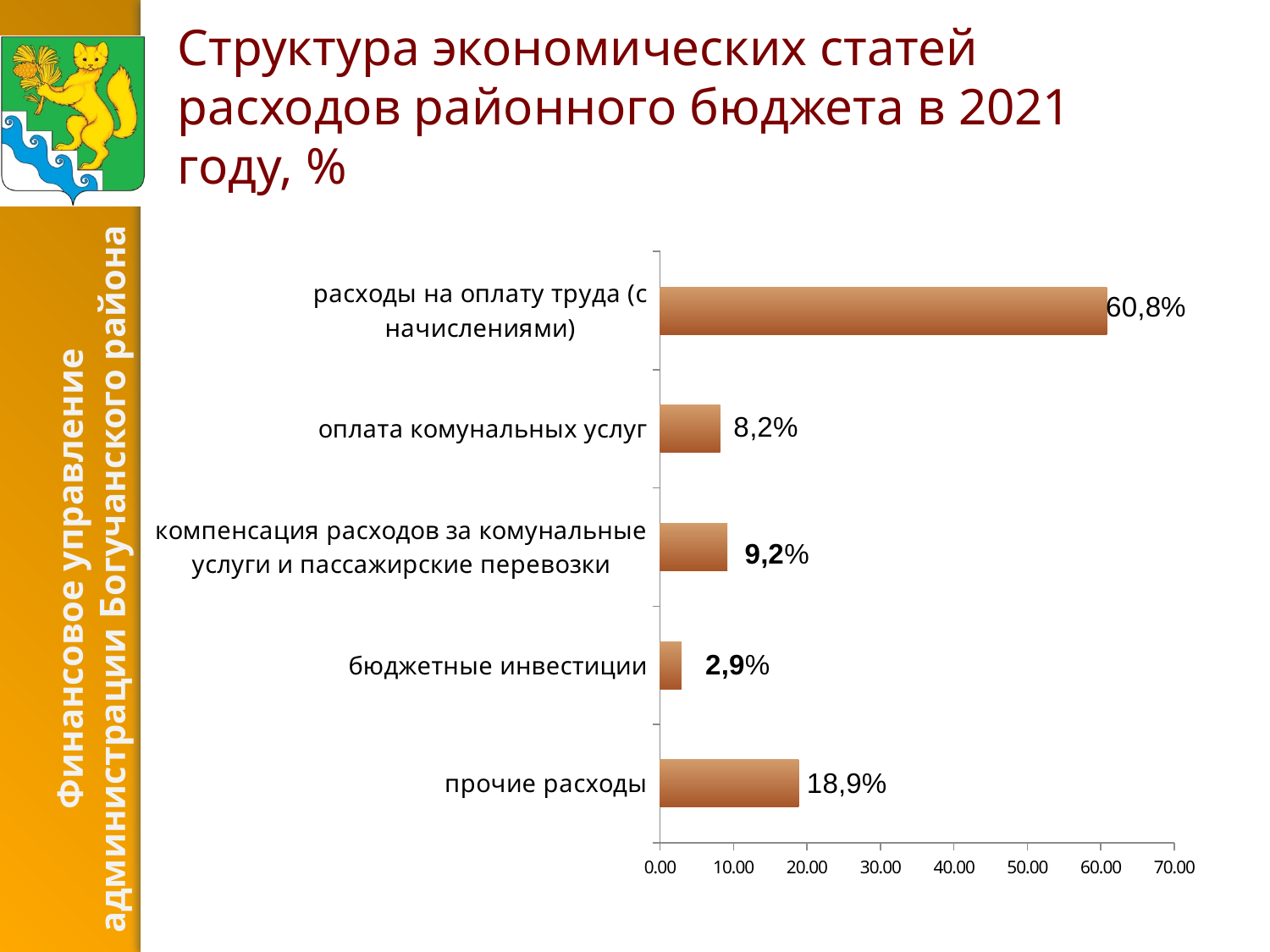
What is the value for «бюджетные инвестиции»? 2,9% Which category has the highest value? расходы на оплату труда (с начислениями) What kind of chart is shown on the slide? bar chart What is the title of the slide? Структура экономических статей расходов районного бюджета в 2021 году, % What is the value for «прочие расходы»? 18,9% What is the value for «оплата комунальных услуг»? 8,2% Is the value for «расходы на оплату труда (с начислениями)» greater or less than 50.00? greater What is the value for «расходы на оплату труда (с начислениями)»? 60,8% Which is larger: «компенсация расходов за комунальные услуги и пассажирские перевозки» or «оплата комунальных услуг»? компенсация расходов за комунальные услуги и пассажирские перевозки Which category has the lowest value? бюджетные инвестиции How many categories are shown in the chart? 5 What is the difference between «прочие расходы» and «оплата комунальных услуг»? 10,7%